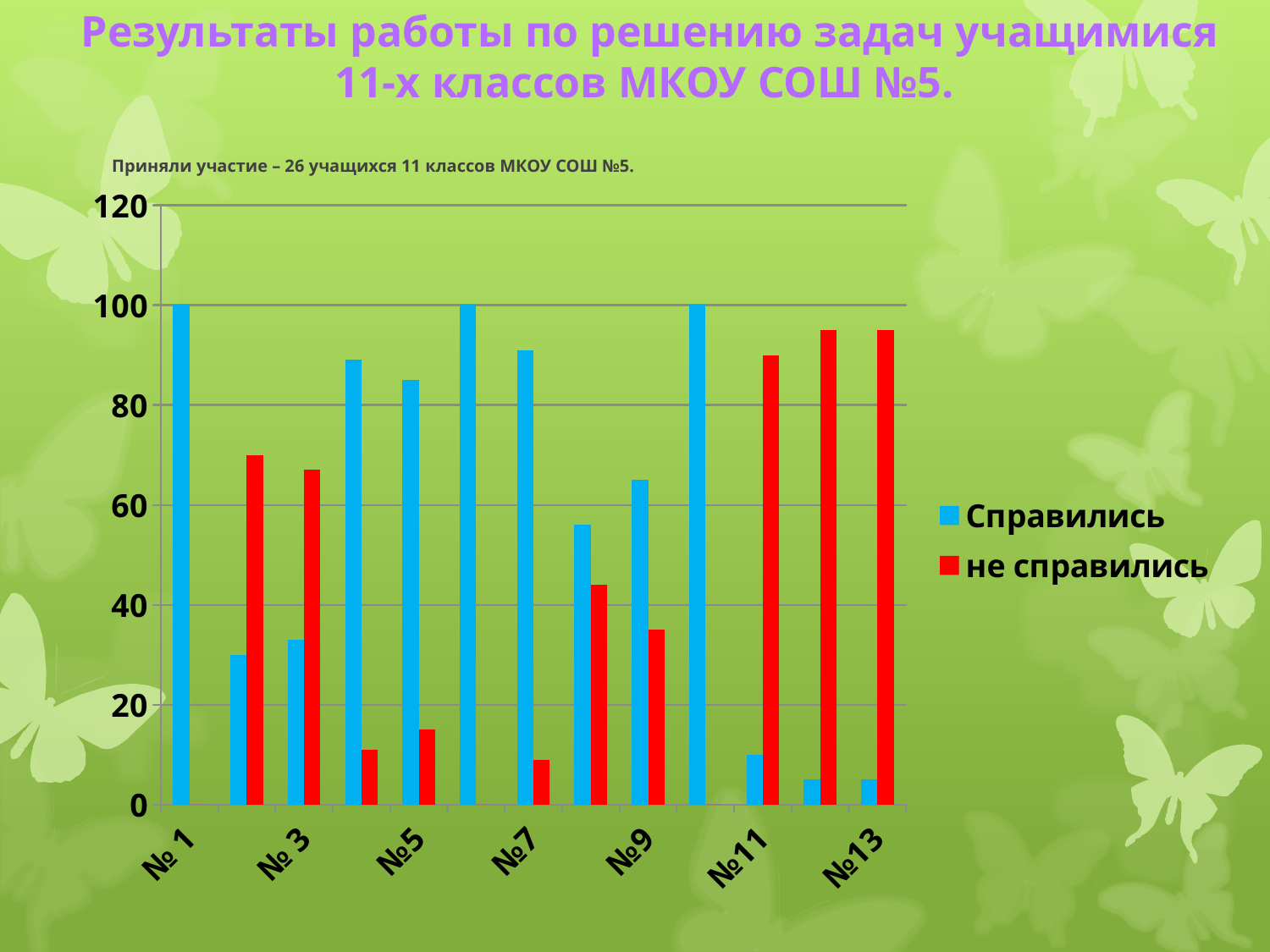
What is the highest value shown on the y axis? 120 What is the value of "Справились" for № 1? 100 Which colour represents the series "не справились"? red Is the value of "Справились" for №9 greater or less than 60? greater How many categories (pairs of bars) are plotted along the x axis? 13 Is the value of "Справились" for № 3 greater or less than 40? less How many series does the legend list? 2 Is the value of "не справились" for №11 greater or less than 80? greater For №5, which is larger: "Справились" or "не справились"? Справились For №13, which is larger: "Справились" or "не справились"? не справились What kind of chart is shown on the slide? bar chart